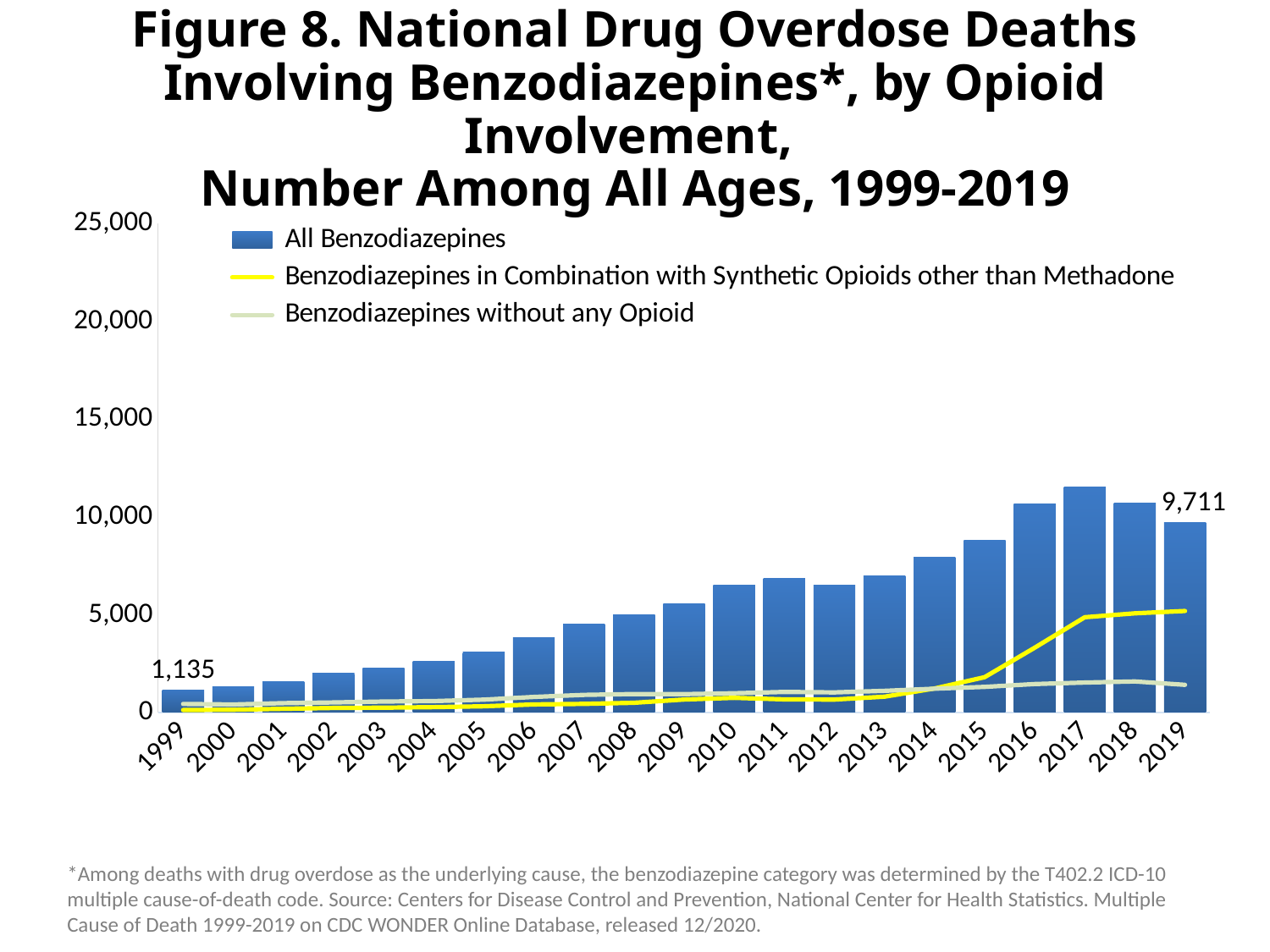
Which is larger in 2019: Benzodiazepines in Combination with Synthetic Opioids other than Methadone or Benzodiazepines without any Opioid? Benzodiazepines in Combination with Synthetic Opioids other than Methadone How many series does the legend list? 3 Is the All Benzodiazepines value for 2017 greater or less than 10,000? greater What is the difference between the All Benzodiazepines values for 2019 and 1999? 8,576 Which year has the lowest value for All Benzodiazepines? 1999 What is the value for All Benzodiazepines in 1999? 1,135 How many years are shown on the x axis? 21 Which year has the highest value for All Benzodiazepines? 2017 Is the All Benzodiazepines value for 2010 greater or less than 5,000? greater What is the value for All Benzodiazepines in 2019? 9,711 What kind of chart is used for the All Benzodiazepines series? Bar chart